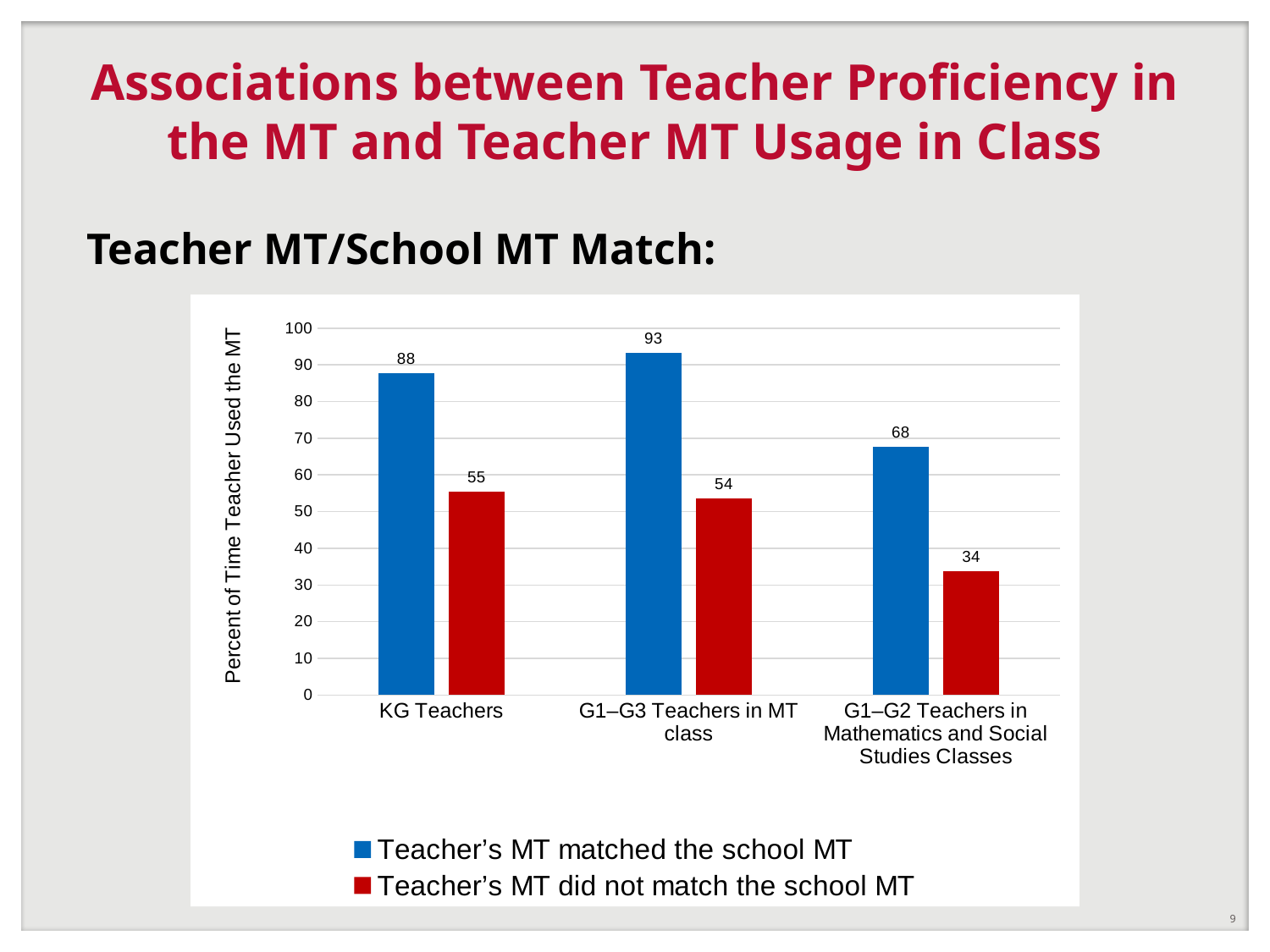
Which category has the highest value in the 'Teacher's MT matched the school MT' series? G1–G3 Teachers in MT class For G1–G3 Teachers in MT class, which series has the larger value: 'Teacher's MT matched the school MT' or 'Teacher's MT did not match the school MT'? Teacher's MT matched the school MT What is the value for G1–G2 Teachers in Mathematics and Social Studies Classes in the 'Teacher's MT matched the school MT' series? 68 What is the label of the y axis? Percent of Time Teacher Used the MT What is the difference between the matched and did-not-match values for G1–G2 Teachers in Mathematics and Social Studies Classes? 34 How many series does the legend list? 2 How many categories are shown on the x axis? 3 What is the value for KG Teachers in the 'Teacher's MT matched the school MT' series? 88 What kind of chart is shown on the slide? Bar chart What is the difference between the matched and did-not-match values for KG Teachers? 33 Which category has the lowest value in the 'Teacher's MT did not match the school MT' series? G1–G2 Teachers in Mathematics and Social Studies Classes What is the value for G1–G3 Teachers in MT class in the 'Teacher's MT did not match the school MT' series? 54